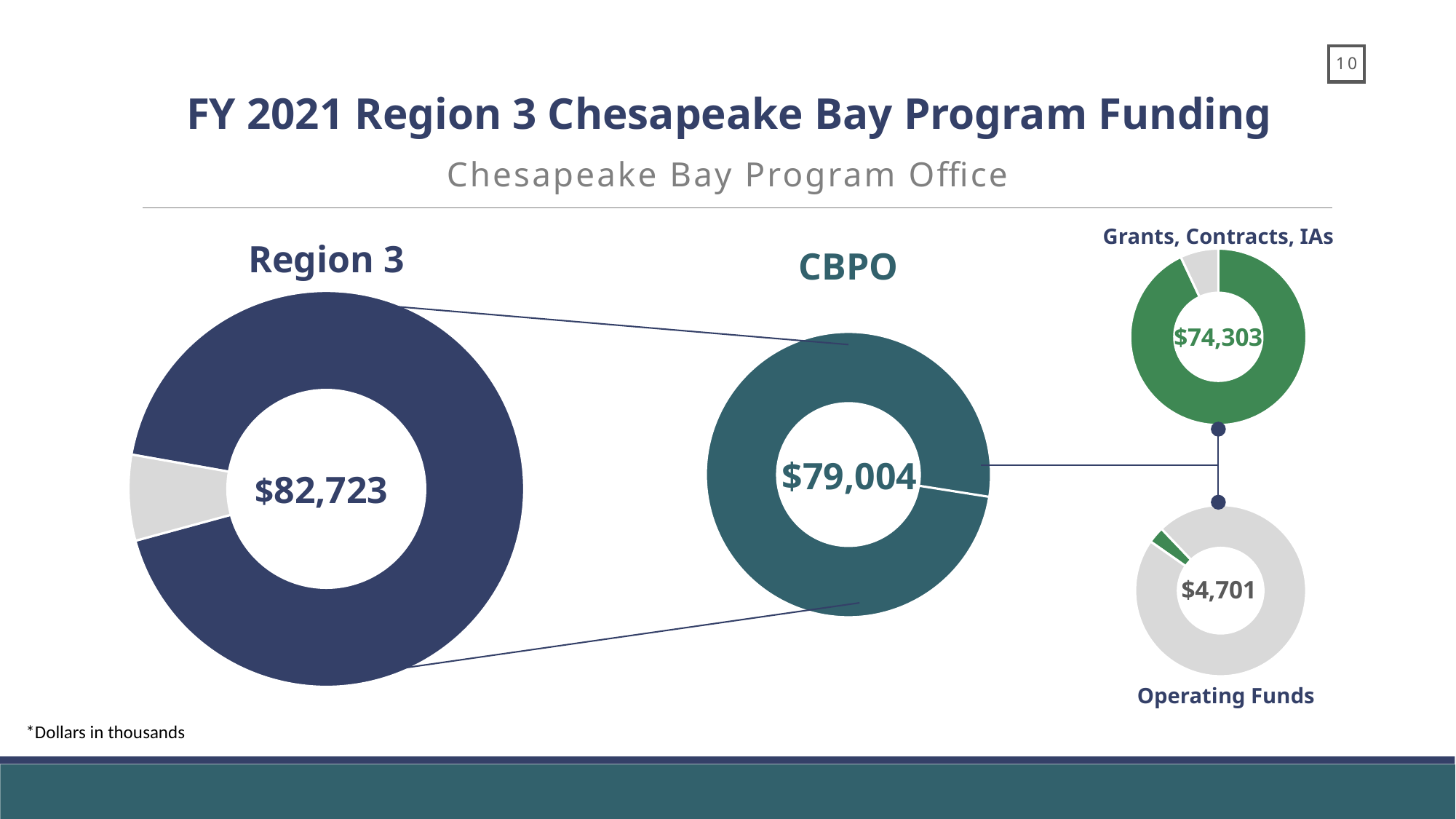
What is the difference between the Region 3 value and the CBPO value? $3,719 What is the sum of the Grants, Contracts, IAs value and the Operating Funds value? $79,004 Which is larger, the Grants, Contracts, IAs value or the Operating Funds value? Grants, Contracts, IAs What value is shown in the centre of the Region 3 donut chart? $82,723 What is the difference between the Grants, Contracts, IAs value and the Operating Funds value? $69,602 What value is shown in the centre of the Operating Funds donut chart? $4,701 How many donut charts are on the slide? 4 What value is shown in the centre of the CBPO donut chart? $79,004 What kind of charts are used on this slide? Donut charts What value is shown in the centre of the Grants, Contracts, IAs donut chart? $74,303 Which is larger, the Region 3 value or the CBPO value? Region 3 What colour is the Grants, Contracts, IAs donut chart? Green